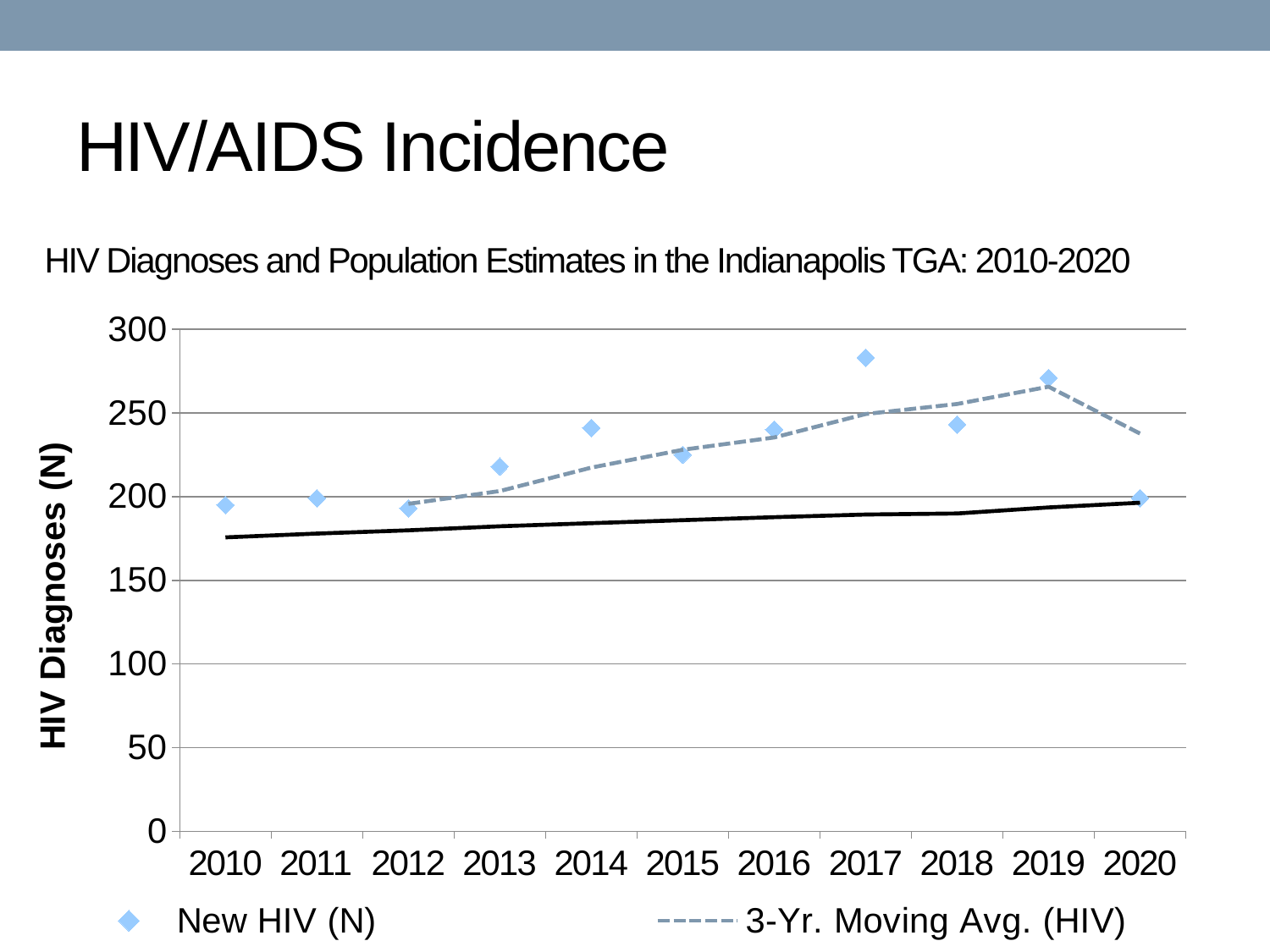
Which year has the larger New HIV (N) value, 2017 or 2018? 2017 How many series does the legend list? 2 In which year is the New HIV (N) value highest? 2017 What kind of chart is shown on the slide? line chart Is the New HIV (N) value for 2013 greater or less than 200? greater What is the label on the vertical axis of the chart? HIV Diagnoses (N) How many years are plotted along the x axis? 11 Which year has the larger New HIV (N) value, 2011 or 2014? 2014 Does the 3-Yr. Moving Avg. (HIV) line rise or fall from 2012 to 2019? rise Is the New HIV (N) value for 2014 greater or less than 250? less Is the New HIV (N) value for 2010 greater or less than 200? less